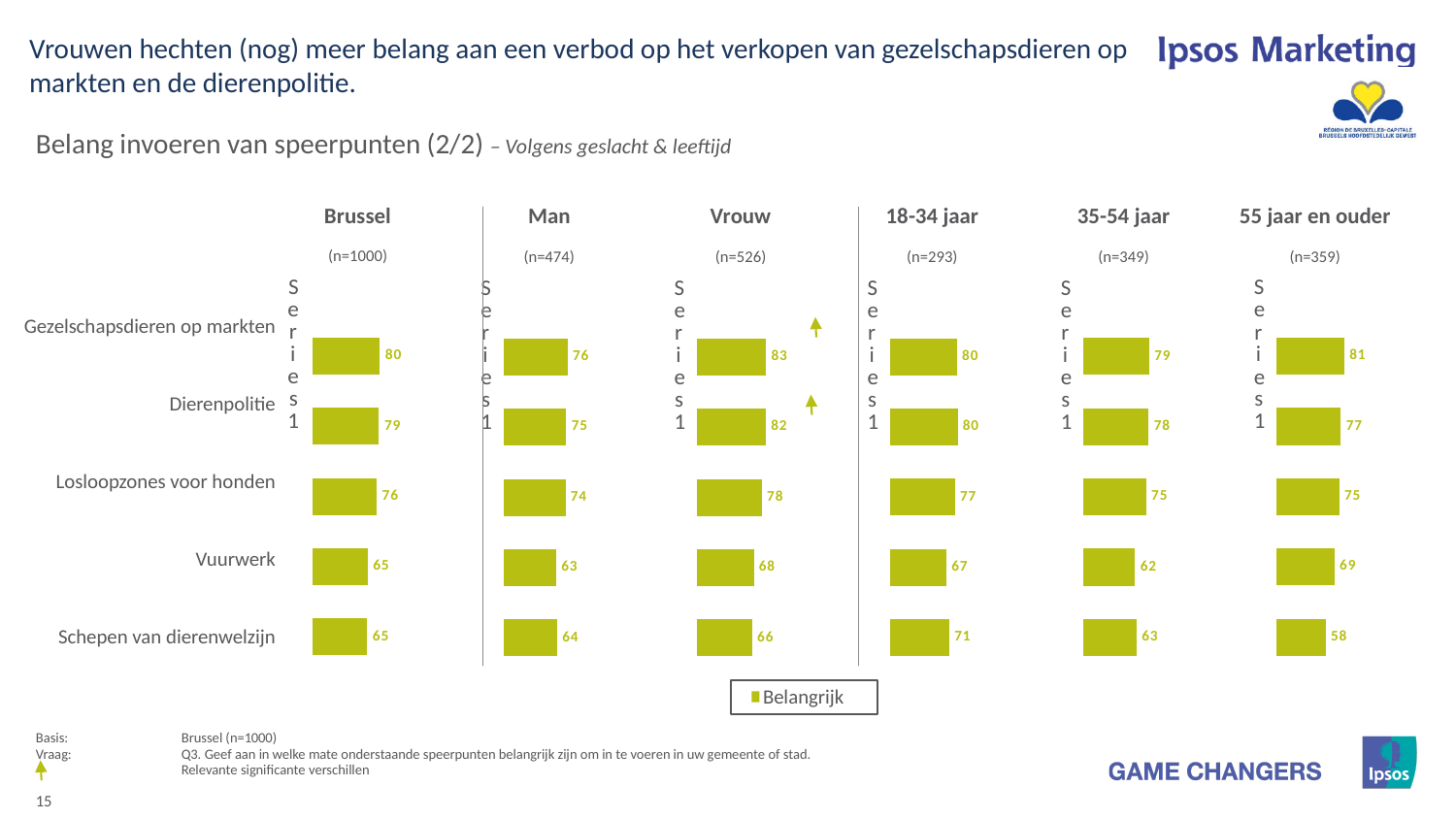
What is the sample size (n) shown for the 55 jaar en ouder chart? n=359 In the Man chart, what is the value for Dierenpolitie? 75 How many categories are shown in the Brussel chart? 5 What kind of chart is used for the Man chart? Bar chart In the 18-34 jaar chart, what is the value for Vuurwerk? 67 Which is larger: Losloopzones voor honden in the Vrouw chart or Losloopzones voor honden in the Man chart? Vrouw In the Vrouw chart, what is the value for Gezelschapsdieren op markten? 83 In the Brussel chart, which category has the highest value? Gezelschapsdieren op markten In the 35-54 jaar chart, which category has the lowest value? Vuurwerk In the Vrouw chart, what is the difference between Gezelschapsdieren op markten and Schepen van dierenwelzijn? 17 How many series does the legend list? 1 In the 55 jaar en ouder chart, what is the value for Schepen van dierenwelzijn? 58